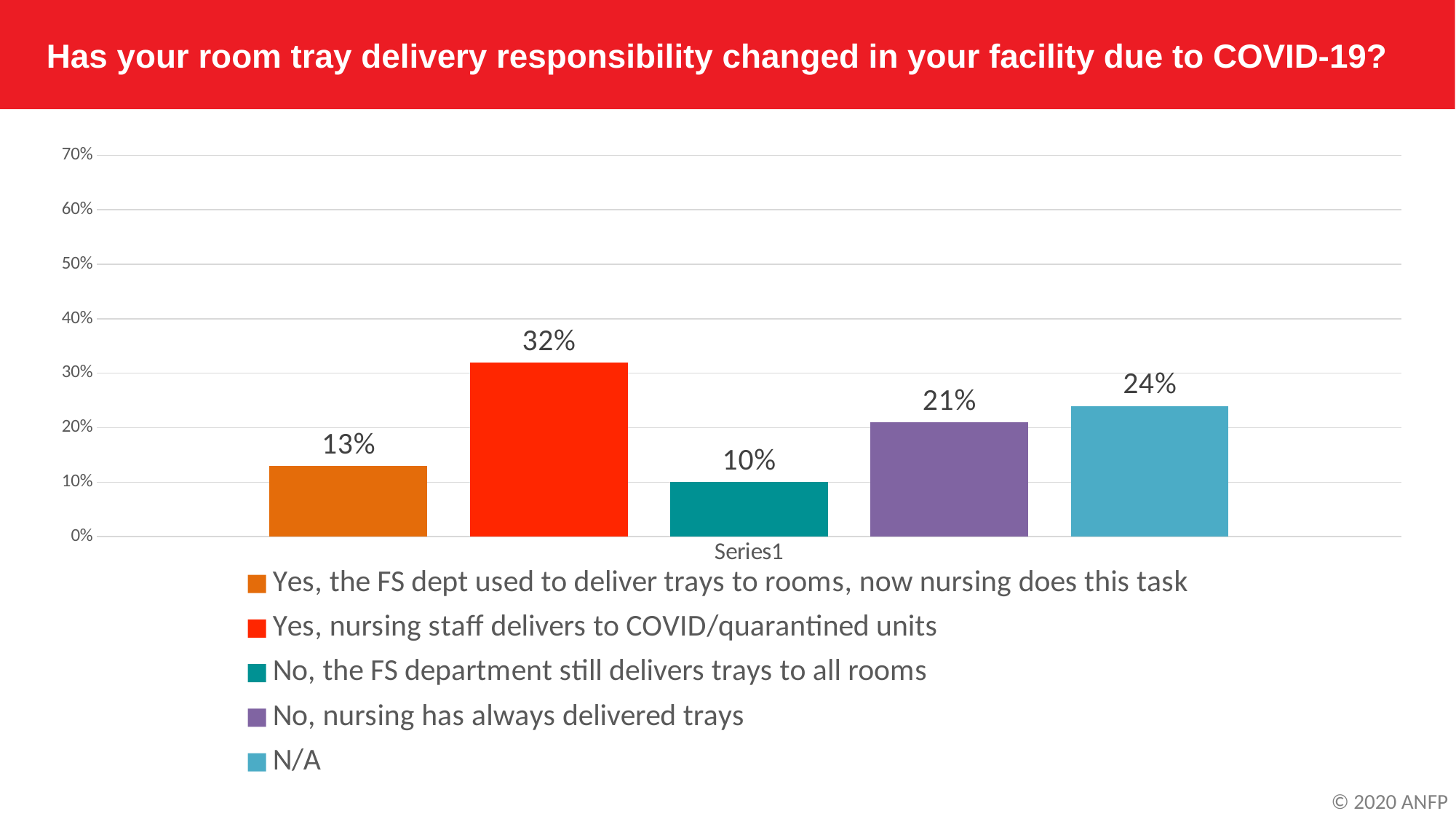
Which response has the lowest percentage? No, the FS department still delivers trays to all rooms What percentage of respondents answered N/A? 24% What kind of chart is shown on the slide? Bar chart What percentage of respondents said nursing staff delivers to COVID/quarantined units? 32% Which response has the highest percentage? Yes, nursing staff delivers to COVID/quarantined units Which is larger: the percentage for 'No, nursing has always delivered trays' or for 'Yes, the FS dept used to deliver trays to rooms, now nursing does this task'? No, nursing has always delivered trays What colour is the bar for 'N/A'? Light blue Is the value for 'Yes, the FS dept used to deliver trays to rooms, now nursing does this task' greater or less than 20%? less What is the difference in percentage points between 'Yes, nursing staff delivers to COVID/quarantined units' and 'N/A'? 8 percentage points What percentage said the FS department still delivers trays to all rooms? 10% What percentage said nursing has always delivered trays? 21% How many response categories are shown in the chart? 5